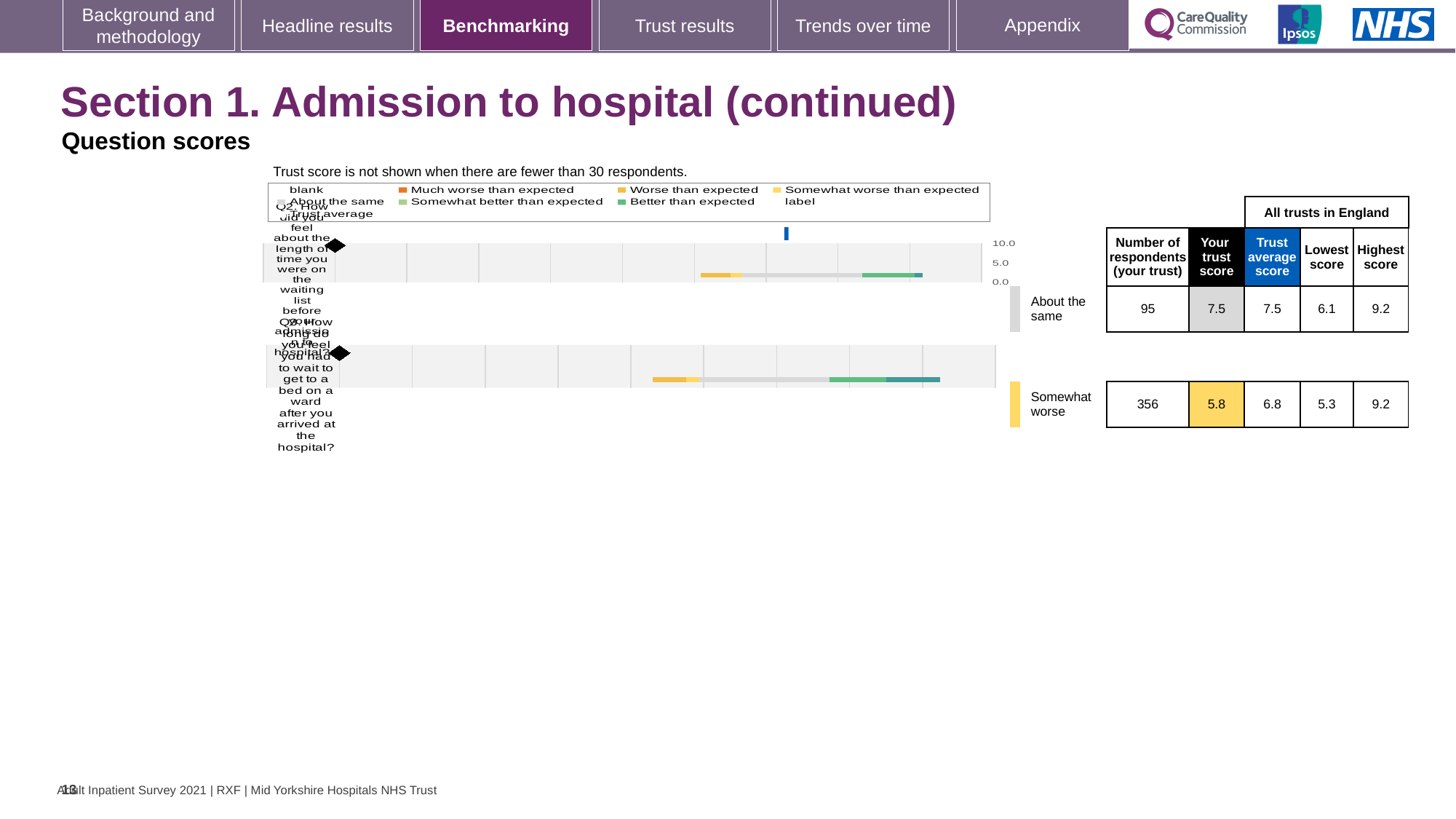
What is the trust score for Q3 (how long did you feel you had to wait to get to a bed on a ward)? 5.8 Which legend entry is shown in orange in the chart legend? Much worse than expected What is the difference between the trust scores for Q2 and Q3? 1.7 What is the maximum value shown on the chart's score axis? 10.0 What is the lowest score across all trusts in England for Q2? 6.1 What kind of chart is used to show the question scores on this slide? bar chart What benchmark category is the trust's Q3 score placed in? Somewhat worse Which question has the higher trust score, Q2 or Q3? Q2 What is the trust score for Q2 (how did you feel about the length of time on the waiting list)? 7.5 What is the trust average score for Q3? 6.8 How many questions (Q2 and Q3) are plotted in the benchmarking chart? 2 How many respondents answered Q3 for this trust? 356